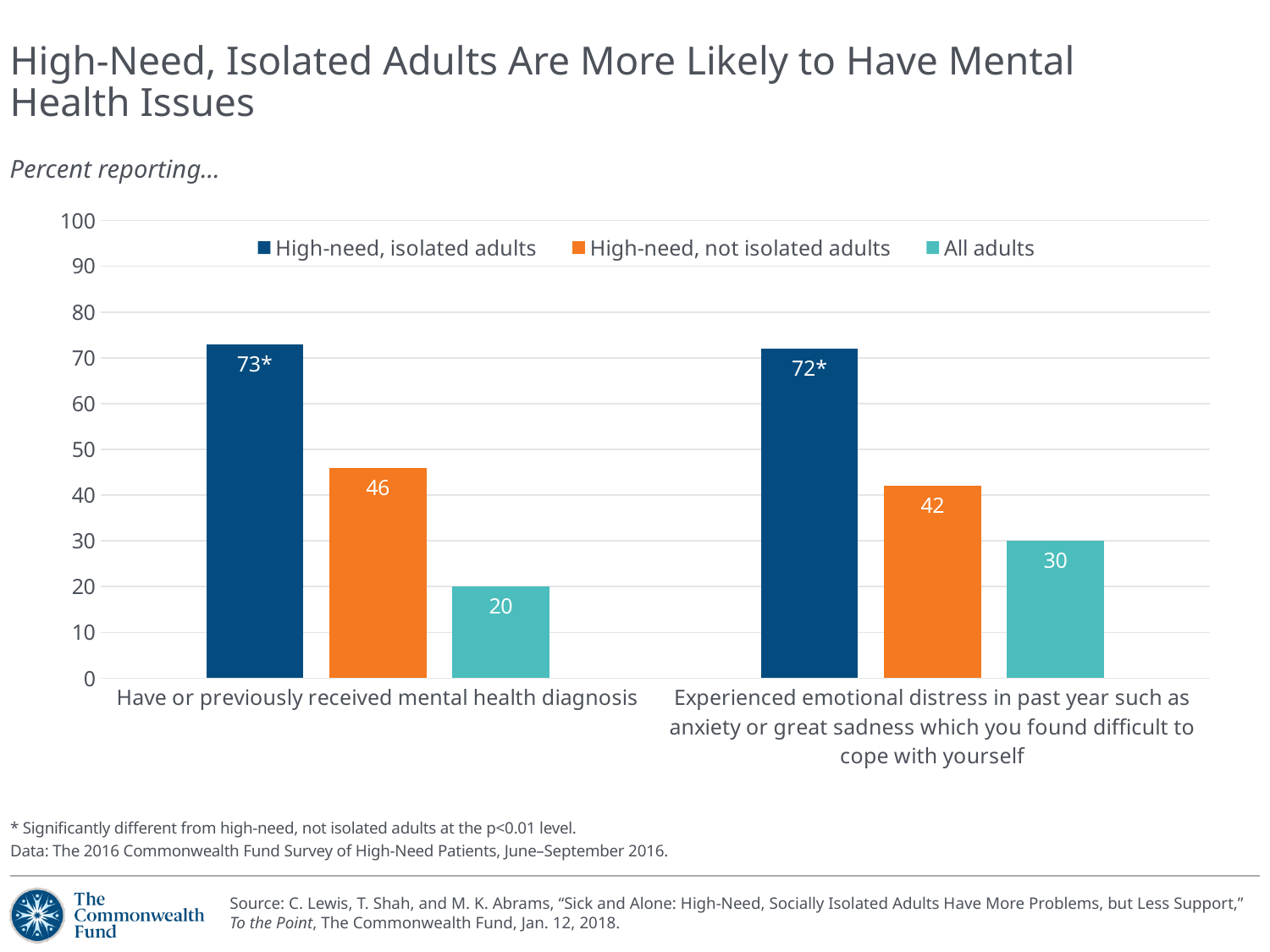
Which group has the highest value for experiencing emotional distress in the past year? High-need, isolated adults Which group has the lowest value for having or previously received a mental health diagnosis? All adults What percent of all adults experienced emotional distress in the past year? 30 What kind of chart is shown on the slide? Bar chart Which series is shown in orange in the legend? High-need, not isolated adults What is the difference between high-need, isolated adults and all adults for having or previously received a mental health diagnosis? 53 How many categories are shown on the x axis? 2 What percent of high-need, isolated adults have or previously received a mental health diagnosis? 73* What percent of high-need, not isolated adults have or previously received a mental health diagnosis? 46 What is the difference between high-need, isolated adults and high-need, not isolated adults for experiencing emotional distress in the past year? 30 How many series does the legend list? 3 Which is larger: the value for high-need, not isolated adults for mental health diagnosis or for emotional distress? Mental health diagnosis (46)